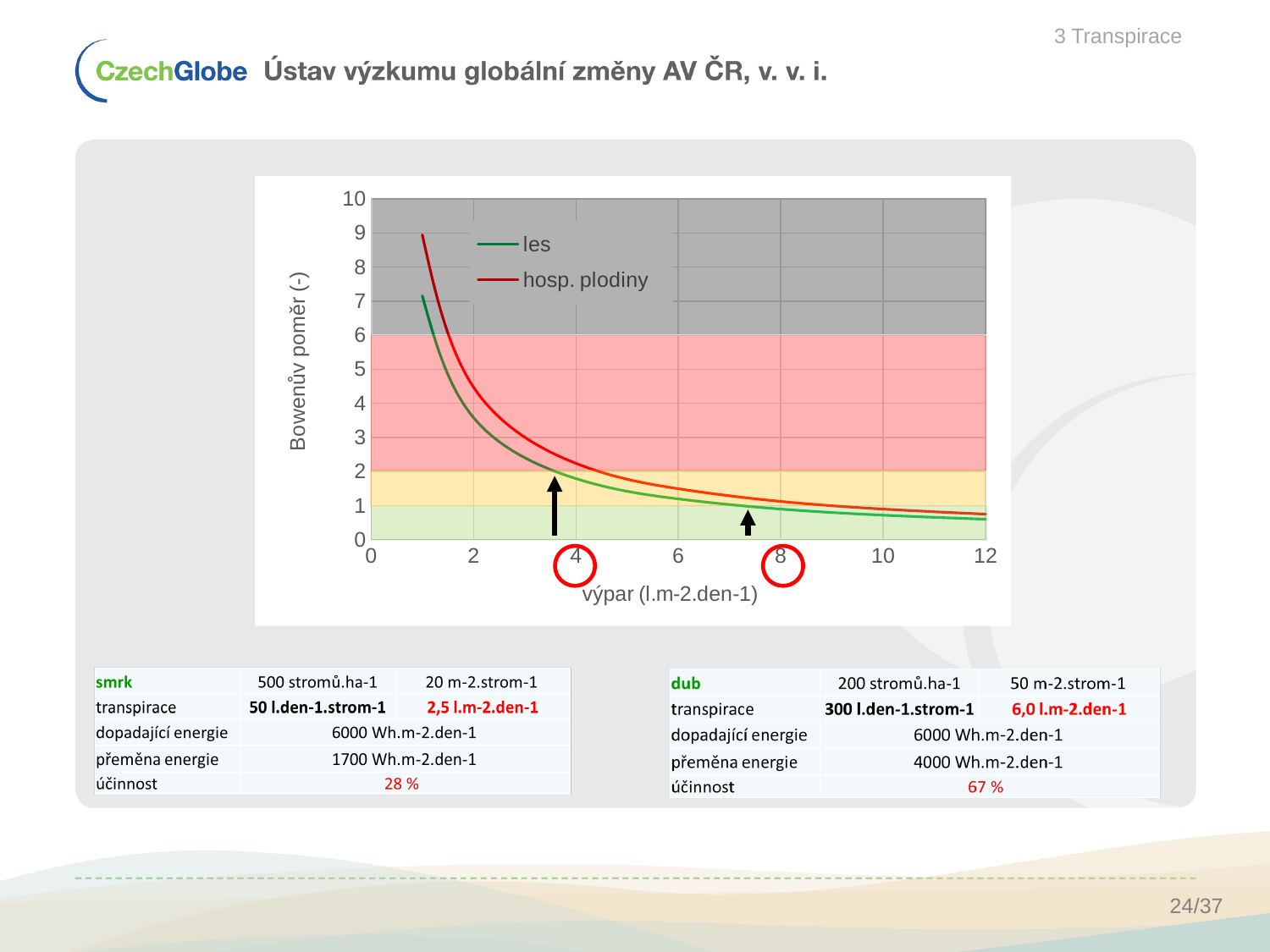
At výpar = 2, is the value of the 'les' series greater or less than 2? greater Do the values of the 'les' series rise or fall as výpar increases along the x axis? fall At výpar = 4, which series has the higher Bowenův poměr, les or hosp. plodiny? hosp. plodiny What are the two series named in the chart legend? les and hosp. plodiny Do the values of the 'hosp. plodiny' series rise or fall as výpar increases along the x axis? fall What is the label of the chart's y axis? Bowenův poměr (-) How many series does the chart legend list? 2 At výpar = 1, is the value of the 'hosp. plodiny' series greater or less than 6? greater At výpar = 10, is the value of the 'hosp. plodiny' series greater or less than 2? less What kind of chart is shown on the slide? line chart What is the maximum value shown on the chart's x axis? 12